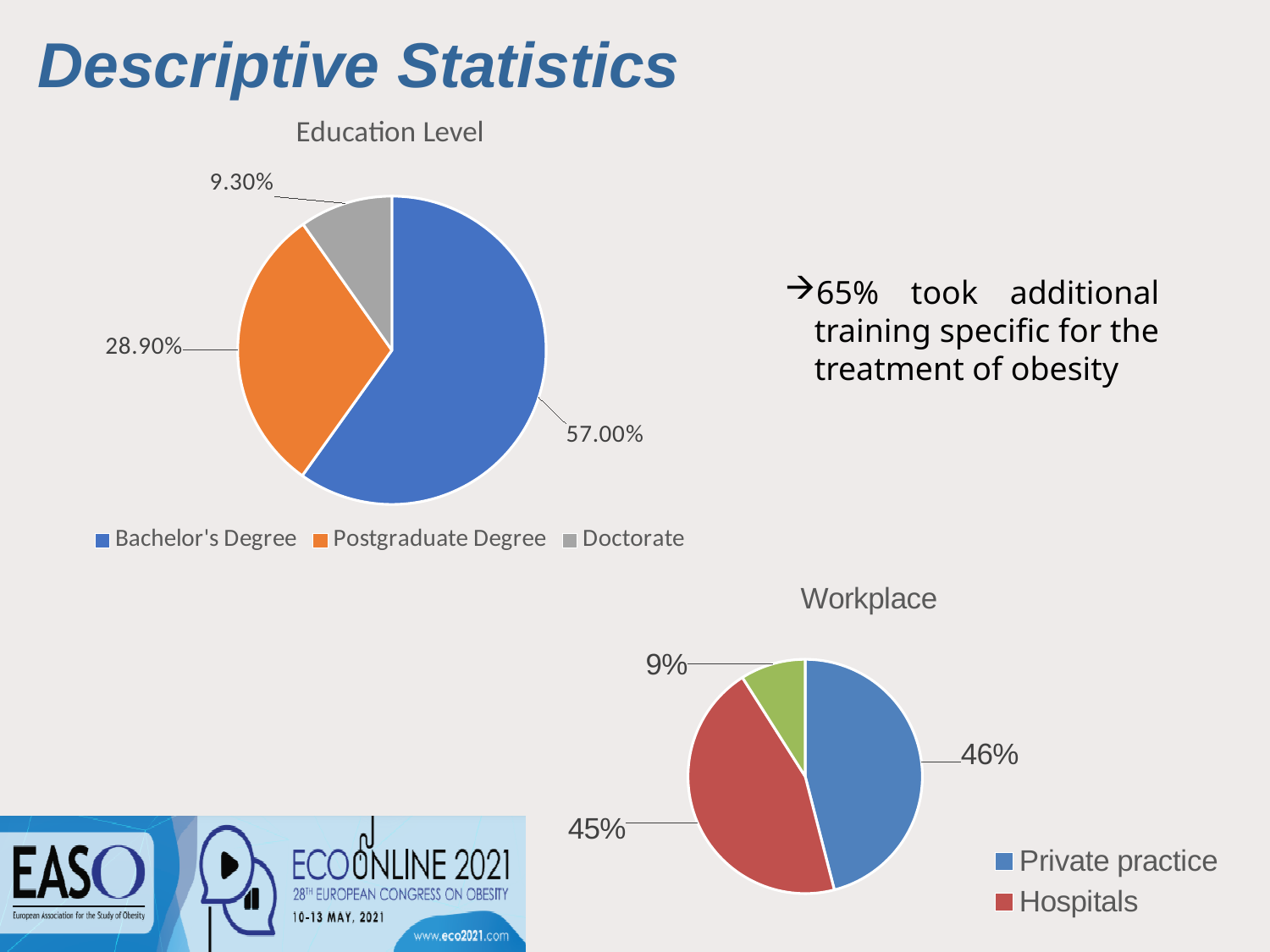
In the Education Level chart, which education level has the largest share? Bachelor's Degree In the Education Level chart, which education level has the smallest share? Doctorate In the Education Level chart, what percentage of respondents hold a Postgraduate Degree? 28.90% In the Education Level chart, how many categories are shown in the legend? 3 In the Education Level chart, what is the difference in percentage points between Bachelor's Degree and Postgraduate Degree? 28.10 In the Education Level chart, what percentage of respondents hold a Doctorate? 9.30% In the Workplace chart, what percentage of respondents work in private practice? 46% In the Education Level chart, what percentage of respondents hold a Bachelor's Degree? 57.00% In the Workplace chart, what is the difference in percentage points between Private practice and Hospitals? 1 In the Workplace chart, what percentage of respondents work in hospitals? 45% What type of chart is the Education Level chart? Pie chart In the Workplace chart, what colour is the Hospitals slice? Red